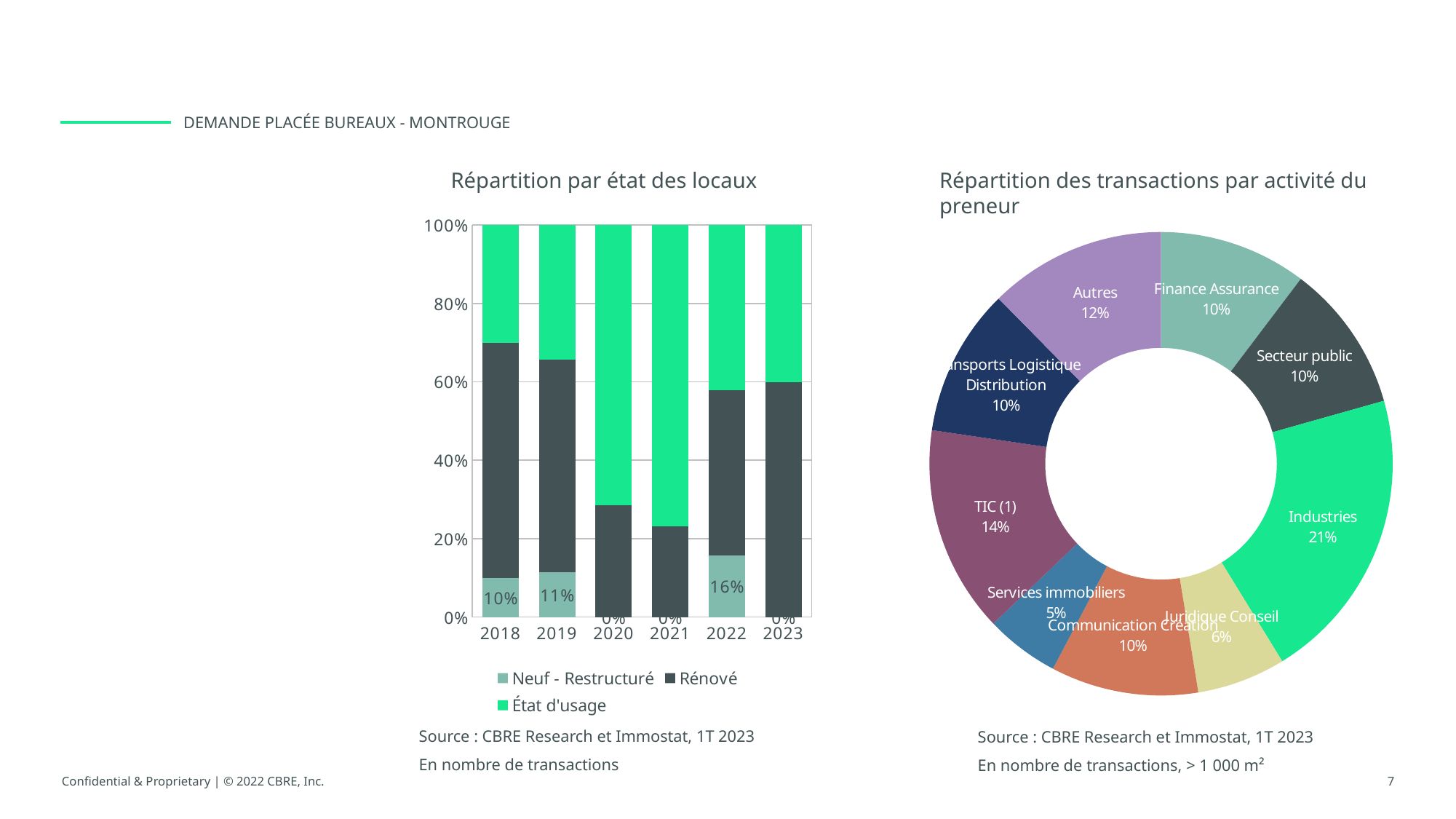
In the chart 'Répartition par état des locaux', how many years are shown on the x axis? 6 In the chart 'Répartition par état des locaux', is the value for Rénové in 2021 greater or less than 40%? less In the chart 'Répartition par état des locaux', is the value for État d'usage in 2021 greater or less than 60%? greater In the chart 'Répartition par état des locaux', what is the value for Neuf - Restructuré in 2019? 11% In the chart 'Répartition par état des locaux', which year has the highest share of Neuf - Restructuré? 2022 In the chart 'Répartition par état des locaux', how many series does the legend list? 3 In the chart 'Répartition des transactions par activité du preneur', which activity has the smallest share? Services immobiliers In the chart 'Répartition des transactions par activité du preneur', what is the share for Industries? 21% In the chart 'Répartition des transactions par activité du preneur', what is the difference between the shares of Industries and TIC (1)? 7 percentage points What kind of chart is 'Répartition par état des locaux'? Stacked bar chart In the chart 'Répartition des transactions par activité du preneur', how many activity categories are shown? 9 In the chart 'Répartition par état des locaux', what is the value for Neuf - Restructuré in 2022? 16%